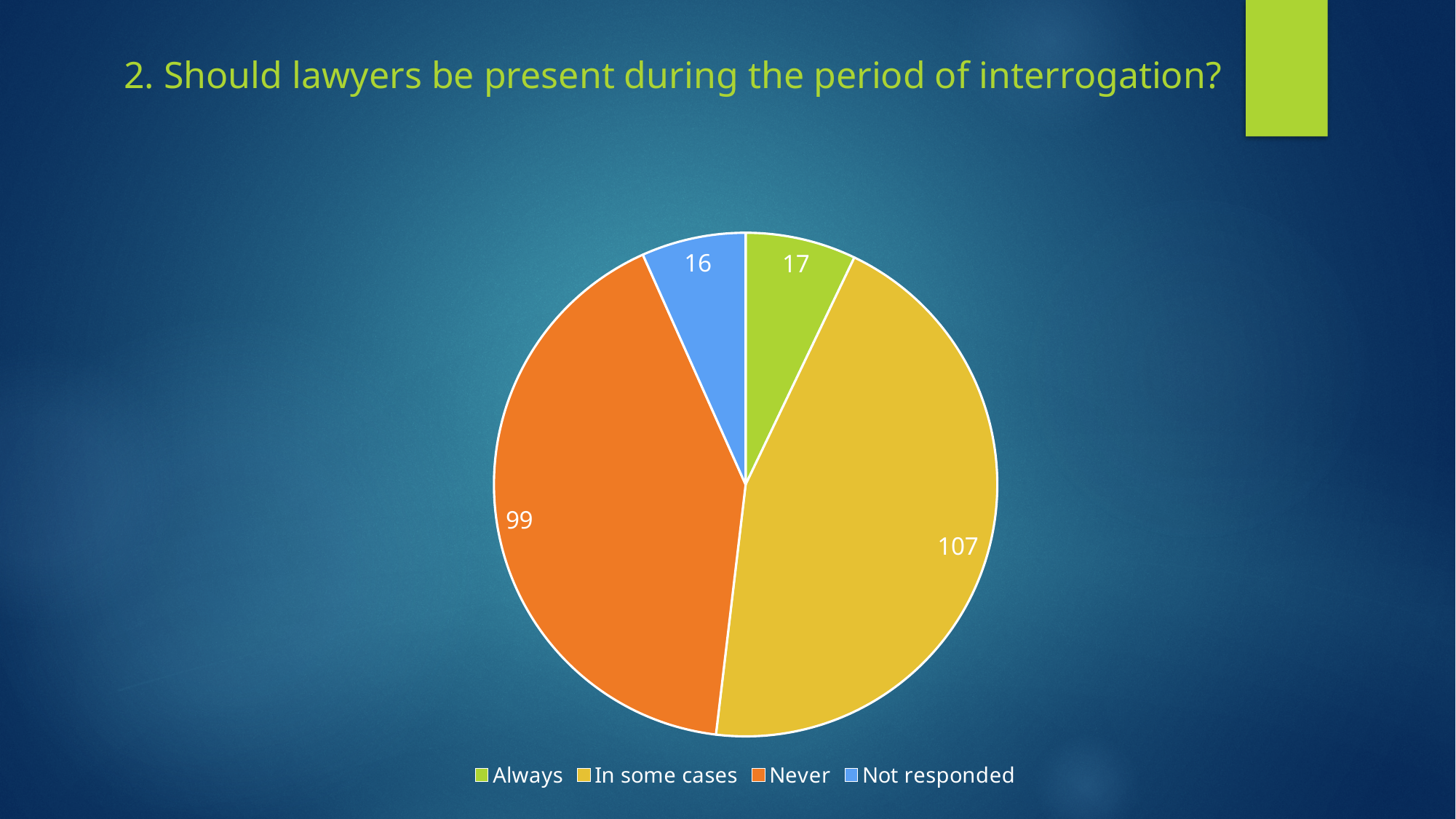
Which category has the smallest slice of the pie? Not responded How many responses are in the "In some cases" slice? 107 How many responses are in the "Never" slice? 99 How many responses are in the "Always" slice? 17 What is the total of all slices in the pie chart? 239 How many responses are in the "Not responded" slice? 16 Which is larger, the "Always" value or the "Not responded" value? Always How many categories does the pie chart have? 4 What kind of chart is shown on the slide? pie chart Which category has the largest slice of the pie? In some cases What is the difference between the "In some cases" and "Never" values? 8 What is the title of the chart on the slide? 2. Should lawyers be present during the period of interrogation?